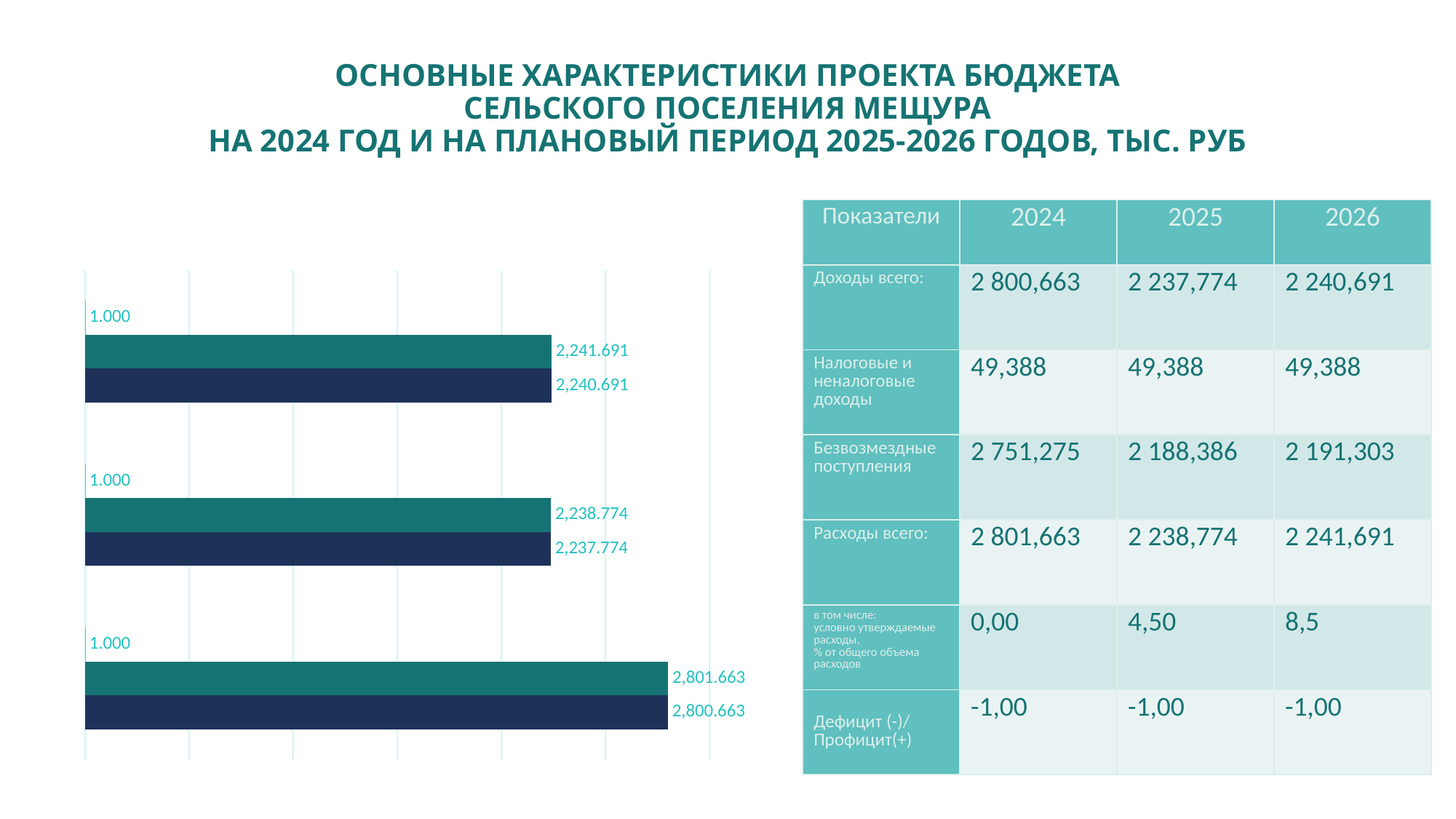
How many groups of bars does the chart on the left contain? 3 In the chart on the left, what small value is labelled above each group of bars? 1.000 In the chart on the left, what is the value labelled on the dark navy bar in the middle group? 2,237.774 In the chart on the left, what is the value labelled on the dark navy bar in the bottom group? 2,800.663 In the chart on the left, what is the difference between the teal bar in the top group and the teal bar in the middle group? 2.917 What kind of chart is shown on the left of the slide? bar chart In the chart on the left, which bar in the middle group is larger, the teal bar or the dark navy bar? the teal bar In the chart on the left, what is the value labelled on the teal bar in the bottom group? 2,801.663 In the chart on the left, what is the largest data label shown on any bar? 2,801.663 In the chart on the left, what is the value labelled on the teal bar in the top group? 2,241.691 In the chart on the left, what is the difference between the teal bar and the dark navy bar in the bottom group? 1.000 In the chart on the left, what is the value labelled on the dark navy bar in the top group? 2,240.691